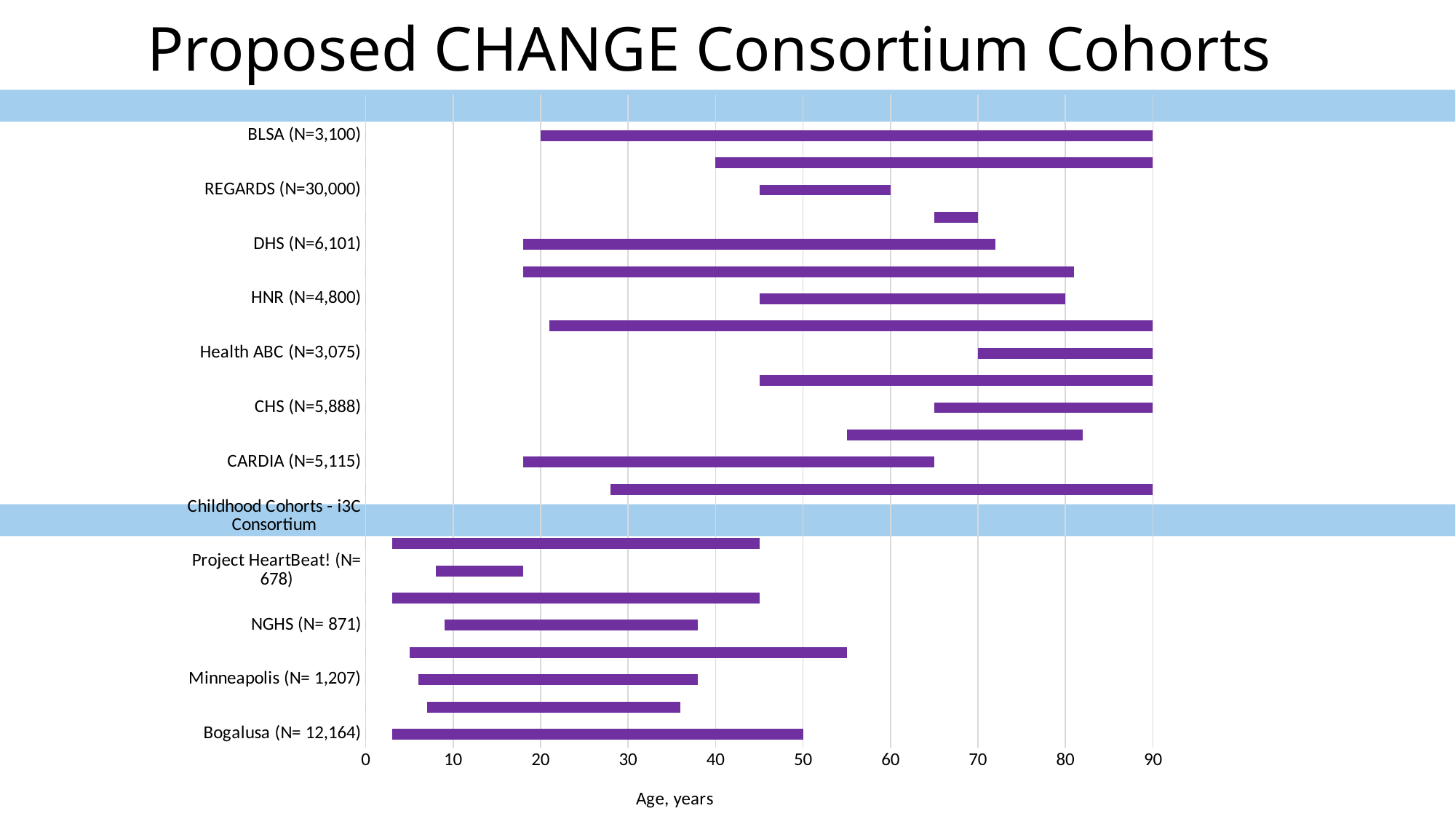
Is the right end of the bar for CARDIA (N=5,115) greater or less than 70? less What is the label of the horizontal axis? Age, years Is the left end of the bar for REGARDS (N=30,000) greater or less than 40? greater Is the left end of the bar for Health ABC (N=3,075) greater or less than 60? greater What kind of chart is shown on the slide? bar chart Which bar extends to a higher age, BLSA (N=3,100) or REGARDS (N=30,000)? BLSA (N=3,100) Which bar starts at a higher age, Health ABC (N=3,075) or CARDIA (N=5,115)? Health ABC (N=3,075) What is the title of the chart on the slide? Proposed CHANGE Consortium Cohorts